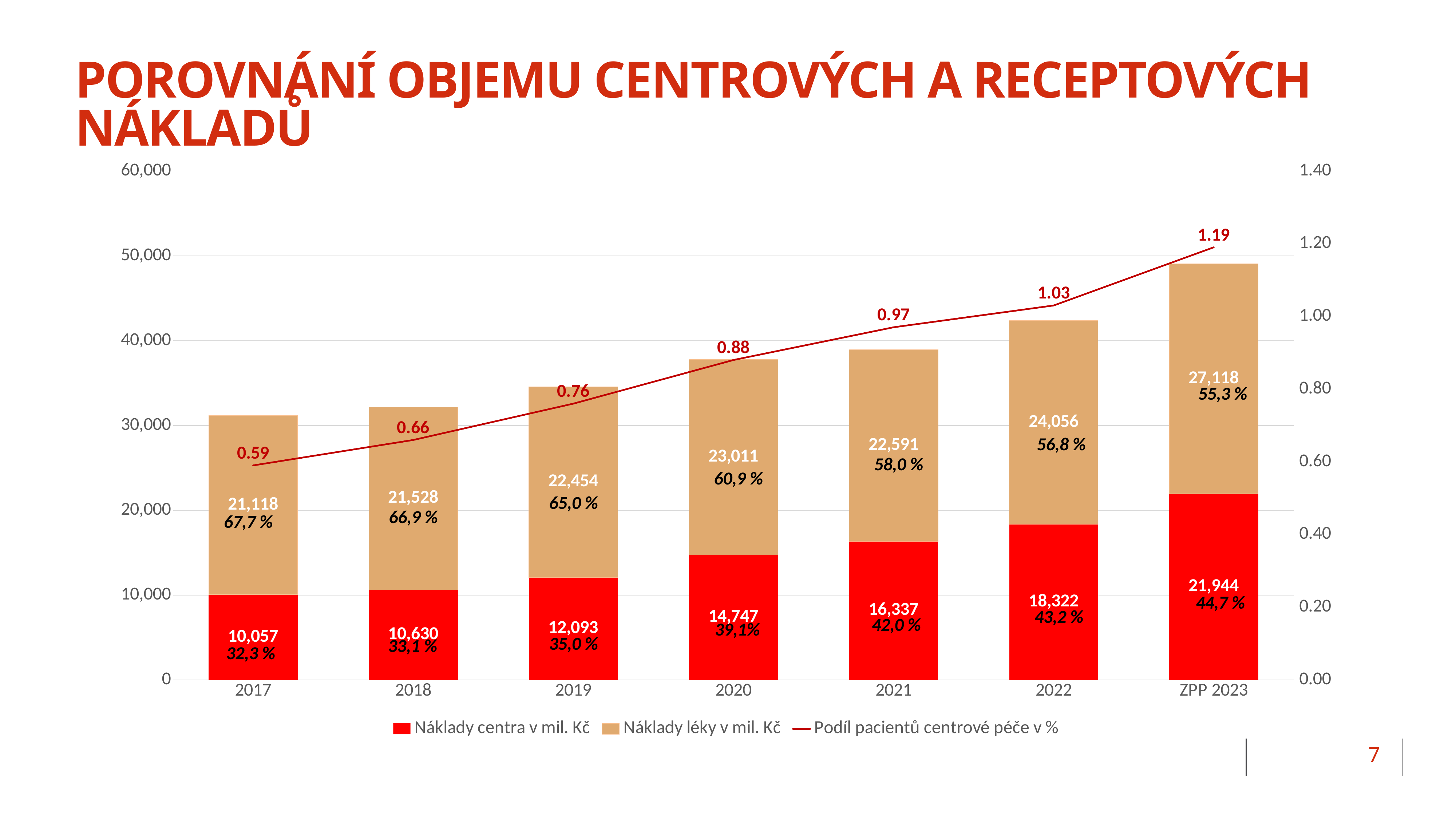
What is the difference between the Podíl pacientů centrové péče v % values for ZPP 2023 and 2017? 0.60 How many years are shown on the x axis? 7 What is the value of Náklady centra v mil. Kč for 2020? 14,747 What is the value of Náklady léky v mil. Kč for 2019? 22,454 Which year has the highest value of Náklady centra v mil. Kč? ZPP 2023 What is the value of Podíl pacientů centrové péče v % for 2021? 0.97 Which year has the lowest value of Podíl pacientů centrové péče v %? 2017 Which is larger: Náklady centra v mil. Kč for 2018 or Náklady léky v mil. Kč for 2018? Náklady léky v mil. Kč What is the total of the stacked bar for 2022? 42,378 Does the Podíl pacientů centrové péče v % line rise or fall from 2017 to ZPP 2023? rise How many series does the legend list? 3 What is the difference between Náklady léky v mil. Kč for 2022 and 2021? 1,465